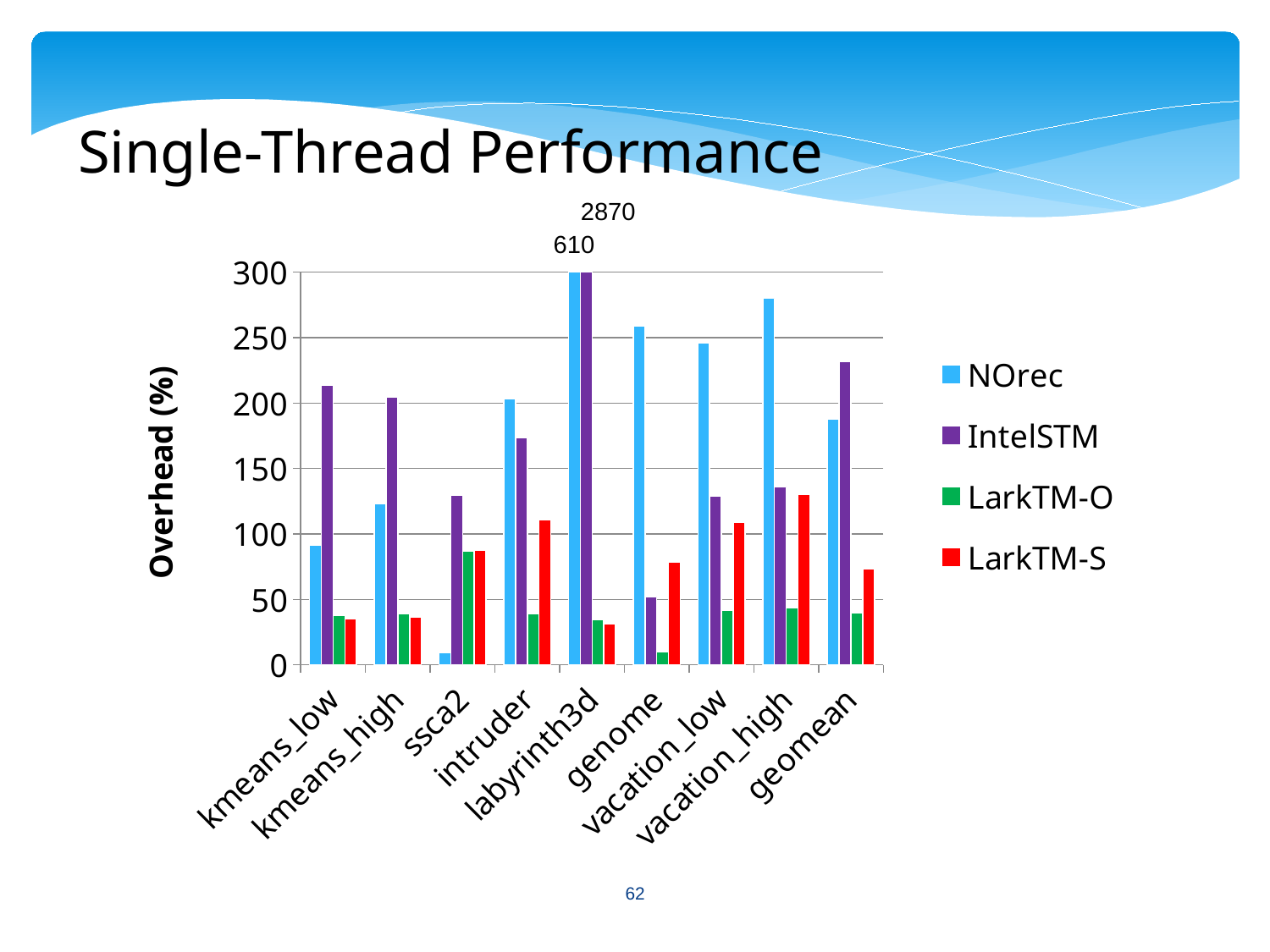
Is the NOrec value for vacation_high greater or less than 250? greater For vacation_high, which is larger: LarkTM-O or LarkTM-S? LarkTM-S How many benchmark categories are shown along the x axis? 9 What is the title of the y axis? Overhead (%) Which series has the lowest overhead for geomean? LarkTM-O For kmeans_low, which is larger: NOrec or IntelSTM? IntelSTM For genome, which is larger: NOrec or IntelSTM? NOrec Is the IntelSTM value for kmeans_low greater or less than 200? greater What kind of chart is shown on the slide? bar chart Is the NOrec value for kmeans_low greater or less than 100? less How many series does the legend list? 4